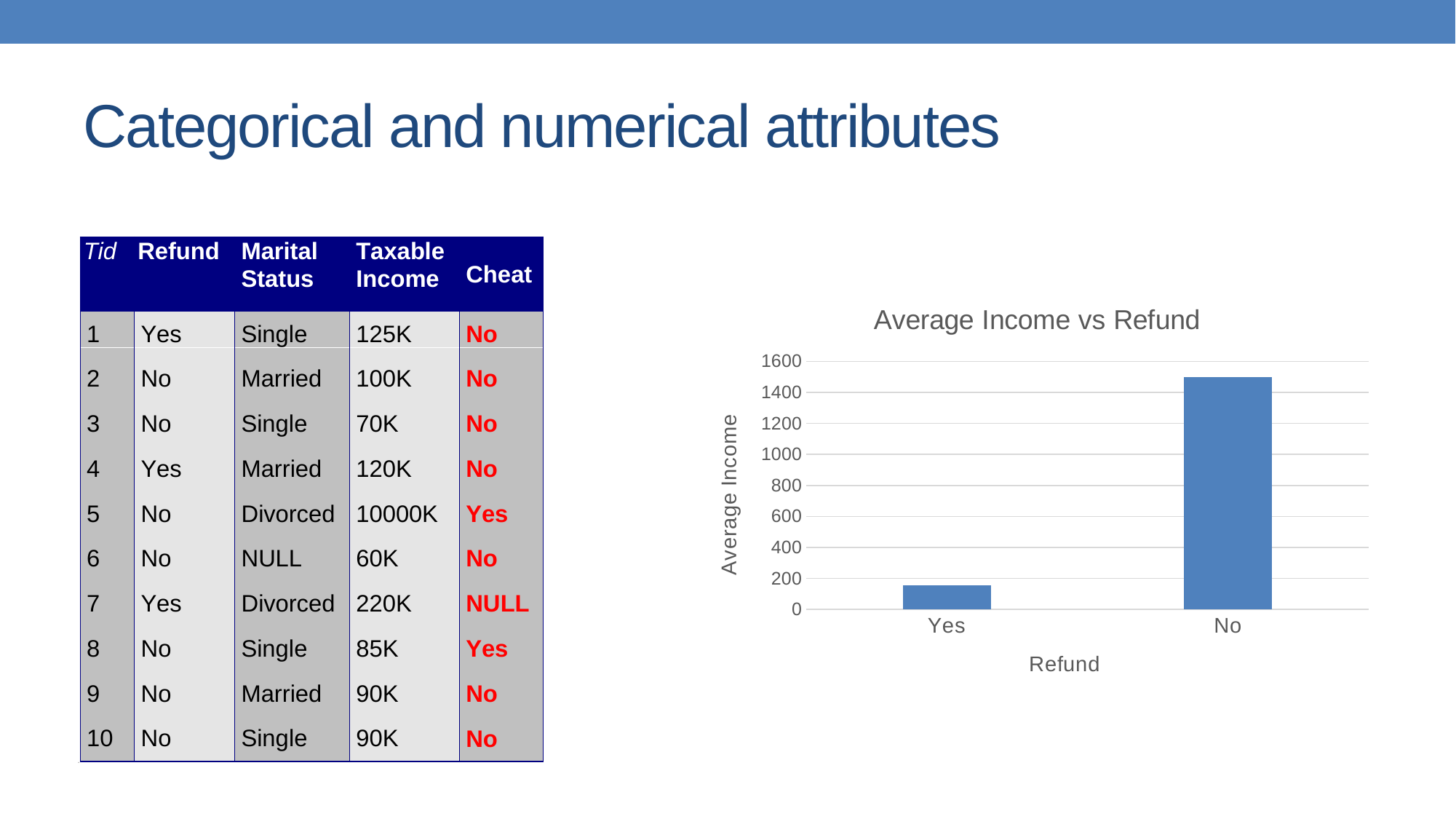
Is the value for Yes greater or less than 200? less What is the label of the y axis of the chart? Average Income Is the value for Yes greater or less than 400? less Which category has the lowest average income in the chart? Yes Is the value for No greater or less than 1400? greater What is the title of the chart? Average Income vs Refund How many categories are plotted on the x axis of the chart? 2 Which category has the highest average income in the chart? No What type of chart is shown on the slide? bar chart Which has the larger average income in the chart, Yes or No? No